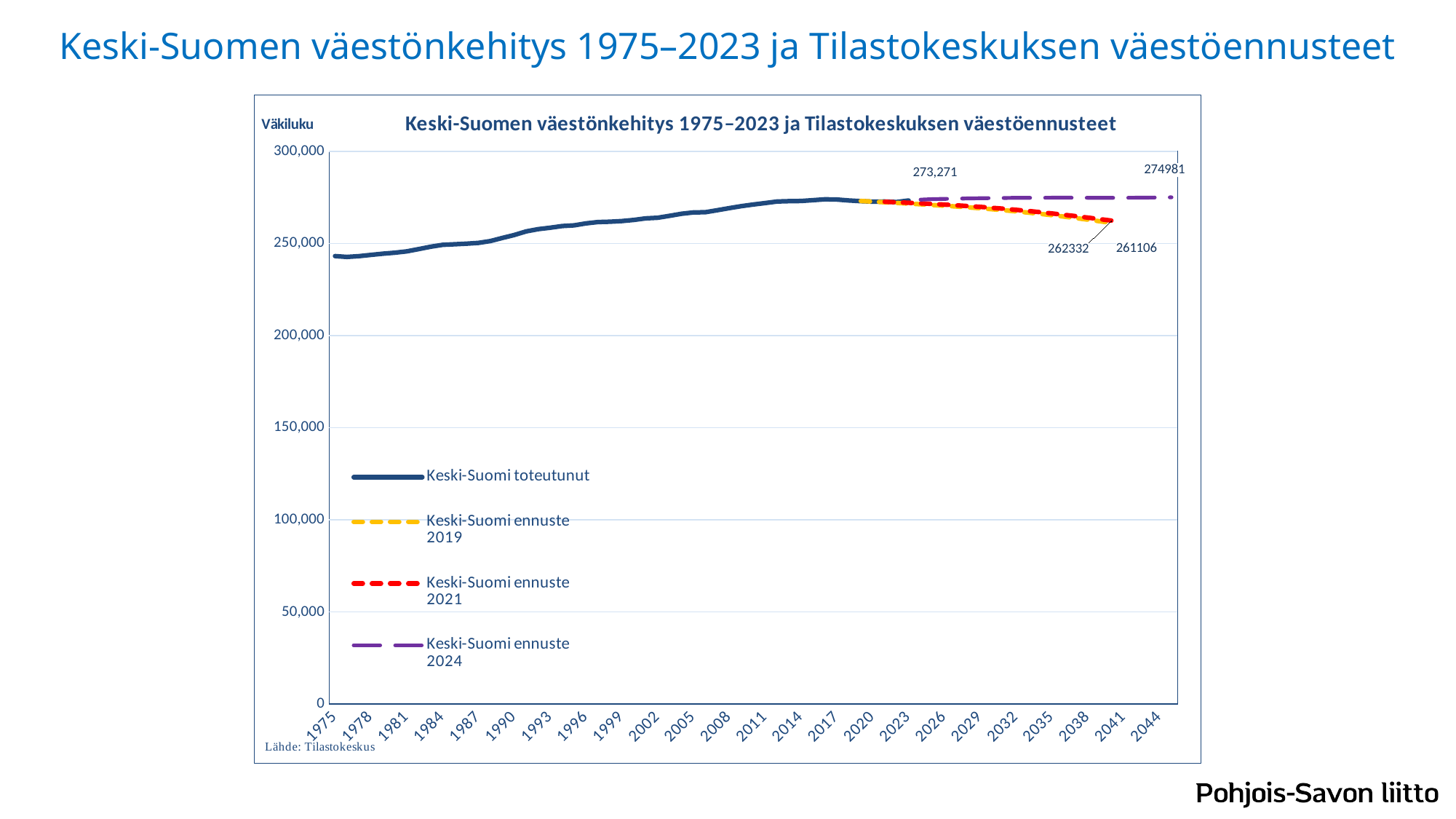
Is the Keski-Suomi ennuste 2024 value in 2044 greater or less than 250,000? greater What value is labelled on the chart near the year 2023? 273,271 What type of chart is shown on the slide? line chart What is the label on the vertical axis of the chart? Väkiluku Does the Keski-Suomi toteutunut line rise or fall between 1975 and 2017? rise Is the Keski-Suomi toteutunut value in 1975 greater or less than 250,000? less Which forecast series ends at the highest value on the right side of the chart? Keski-Suomi ennuste 2024 What value is labelled at the end of the Keski-Suomi ennuste 2024 line? 274981 How many series does the legend list? 4 Which series is drawn as a solid dark blue line? Keski-Suomi toteutunut Does the Keski-Suomi ennuste 2021 line rise or fall from 2023 to 2040? fall Is the Keski-Suomi toteutunut value in 1975 greater or less than 200,000? greater